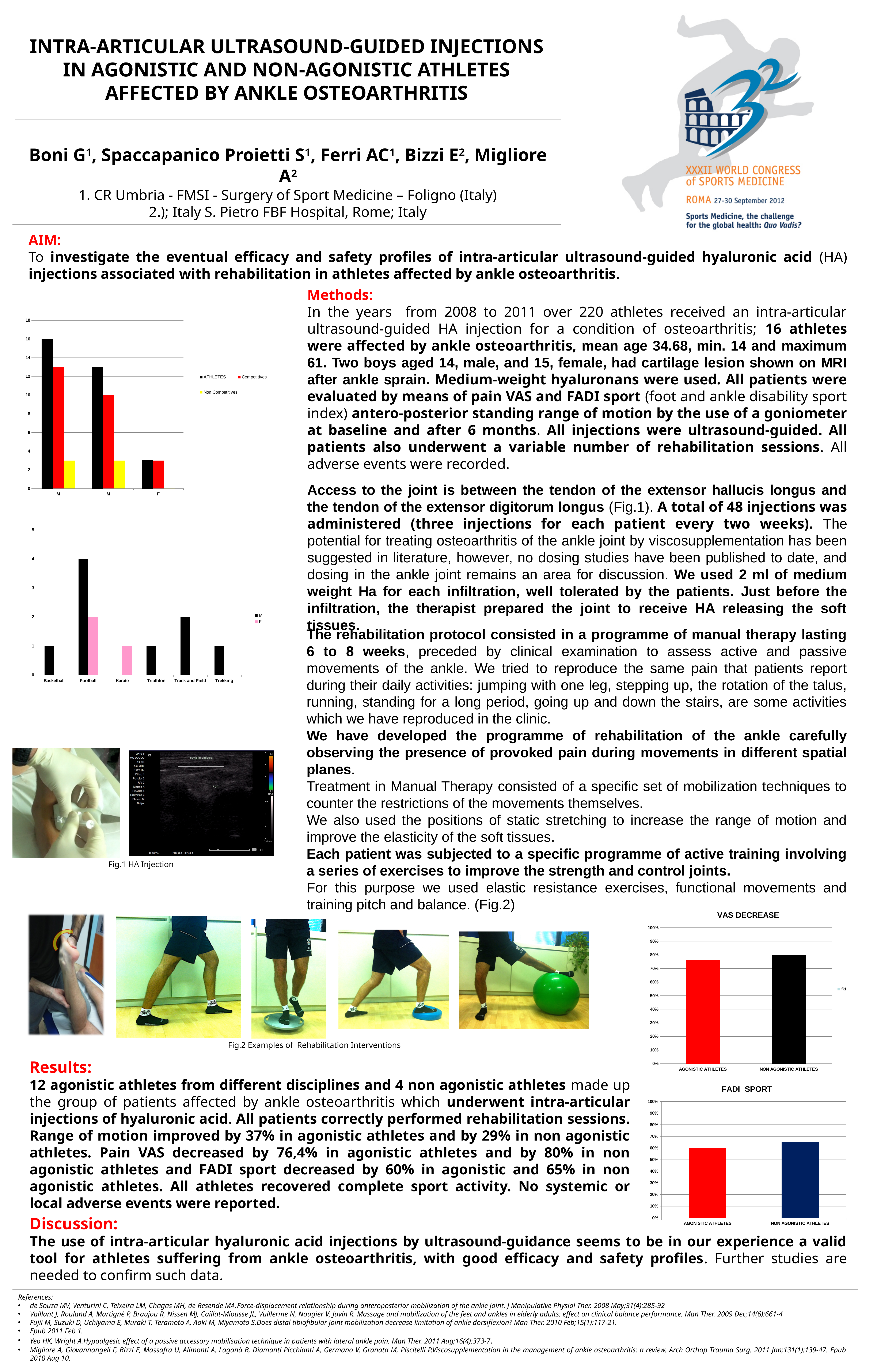
In the FADI SPORT chart, which category has the larger value, AGONISTIC ATHLETES or NON AGONISTIC ATHLETES? NON AGONISTIC ATHLETES In the top-left bar chart (categories M, M, F), which series has the tallest bar in the first M category? ATHLETES In the top-left bar chart (categories M, M, F), is the Competitives value for the F category greater or less than 6? less In the sports bar chart (Basketball to Trekking), what is the F value for Karate? 1 In the top-left bar chart (categories M, M, F), how many series does the legend list? 3 In the sports bar chart (Basketball to Trekking), how many categories are shown on the x axis? 6 In the top-left bar chart (categories M, M, F), is the ATHLETES value for the first M category greater or less than 14? greater In the VAS DECREASE chart, what is the value for NON AGONISTIC ATHLETES? 80% In the sports bar chart (Basketball to Trekking), which category has the highest M value? Football In the VAS DECREASE chart, is the value for AGONISTIC ATHLETES greater or less than 70%? greater In the sports bar chart (Basketball to Trekking), what is the difference between the M value for Football and the M value for Track and Field? 2 In the sports bar chart (Basketball to Trekking), what is the M value for Football? 4